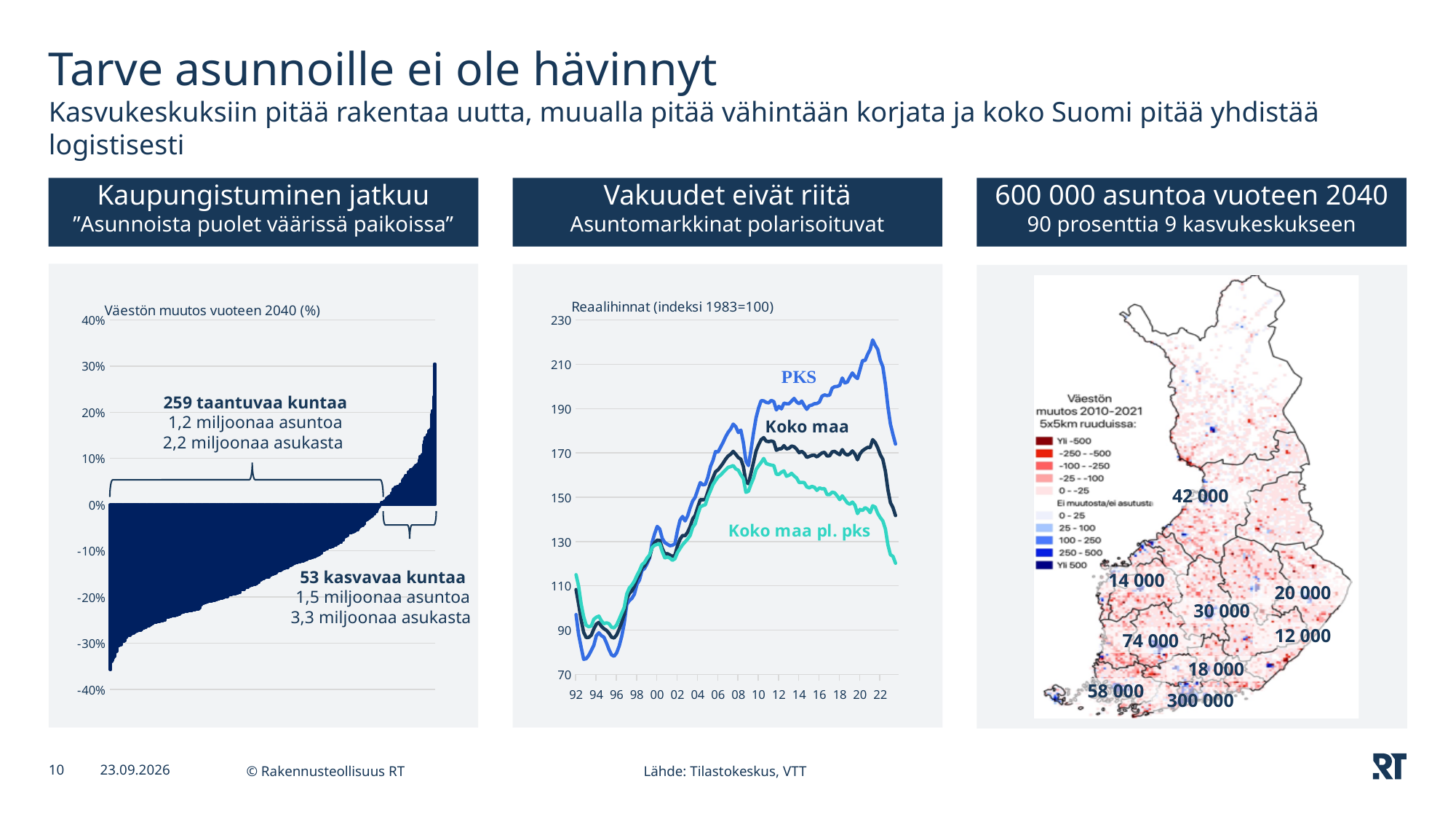
In the middle chart "Reaalihinnat (indeksi 1983=100)", is the peak value of the PKS series greater or less than 210? greater What kind of chart is shown in the middle panel titled "Reaalihinnat (indeksi 1983=100)"? line chart In the left chart "Väestön muutos vuoteen 2040 (%)", do the bar values rise or fall from left to right along the x axis? rise In the left chart "Väestön muutos vuoteen 2040 (%)", is the value of the lowest bar greater or less than -30%? less In the middle chart "Reaalihinnat (indeksi 1983=100)", which series reaches the highest value? PKS In the left chart "Väestön muutos vuoteen 2040 (%)", how many growing municipalities (kasvavaa kuntaa) are annotated? 53 How many series are plotted in the middle chart "Reaalihinnat (indeksi 1983=100)"? 3 In the left chart "Väestön muutos vuoteen 2040 (%)", how many declining municipalities (taantuvaa kuntaa) are annotated? 259 In the middle chart "Reaalihinnat (indeksi 1983=100)", which series is higher around 2020: PKS or Koko maa pl. pks? PKS What kind of chart is shown in the left panel titled "Väestön muutos vuoteen 2040 (%)"? bar chart In the left chart "Väestön muutos vuoteen 2040 (%)", how many dwellings are attributed to the 53 growing municipalities? 1,5 miljoonaa asuntoa In the middle chart "Reaalihinnat (indeksi 1983=100)", is the final value of the "Koko maa pl. pks" series greater or less than 130? less